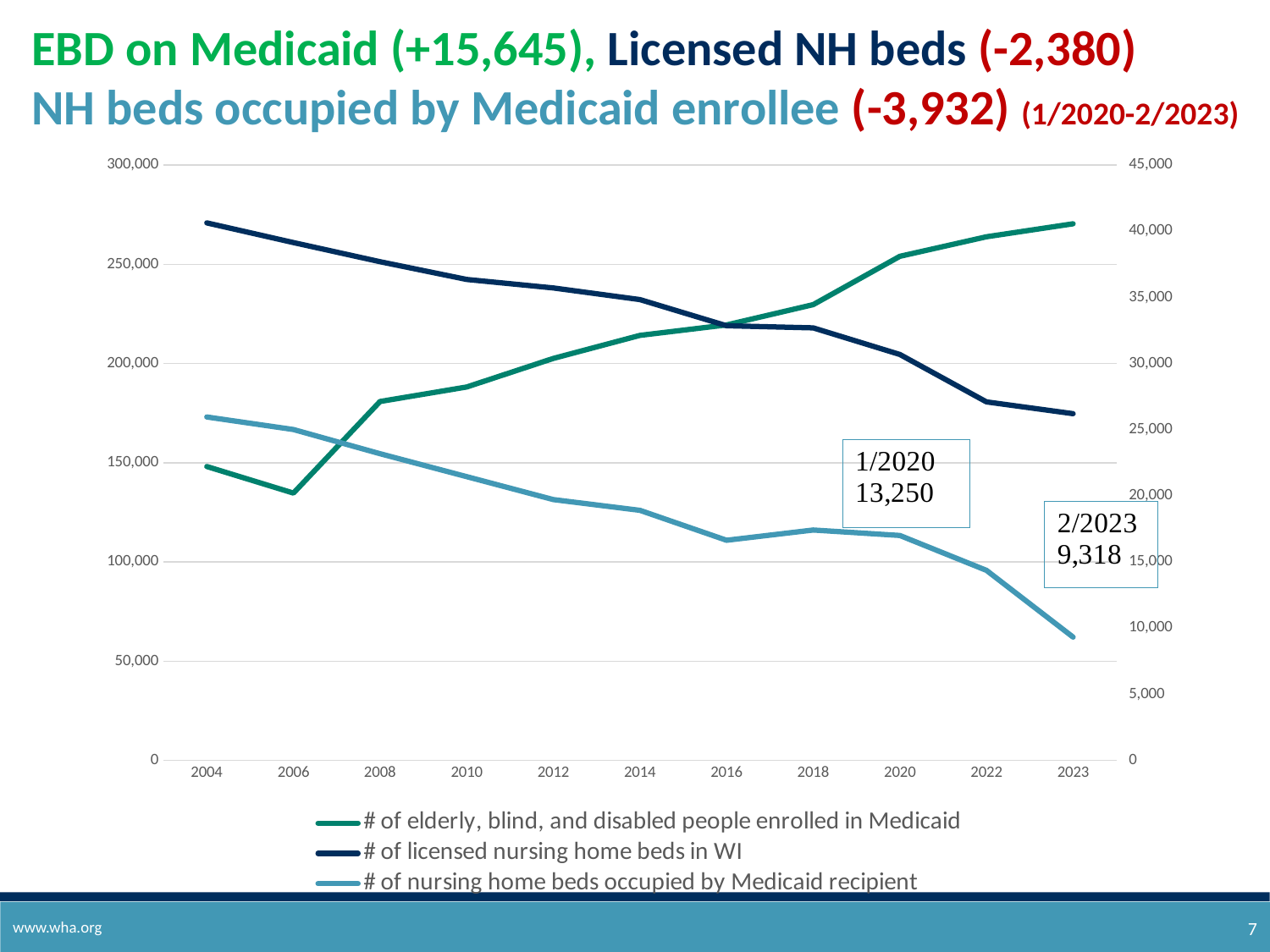
What value is shown in the annotation box labeled 1/2020? 13,250 In which year does the line for # of licensed nursing home beds in WI reach its highest point? 2004 In which year does the line for # of elderly, blind, and disabled people enrolled in Medicaid reach its lowest point? 2006 How many series does the legend list? 3 At 2023, which line is plotted higher on the chart: # of elderly, blind, and disabled people enrolled in Medicaid or # of licensed nursing home beds in WI? # of elderly, blind, and disabled people enrolled in Medicaid In which year does the line for # of nursing home beds occupied by Medicaid recipient reach its lowest point? 2023 What kind of chart is shown on the slide? Line chart How many years are labeled along the x axis? 11 What value is shown in the annotation box labeled 2/2023? 9,318 Does the line for # of elderly, blind, and disabled people enrolled in Medicaid rise or fall overall from 2004 to 2023? Rise Does the line for # of licensed nursing home beds in WI rise or fall from 2004 to 2023? Fall According to the slide title, by how much did NH beds occupied by Medicaid enrollee change from 1/2020 to 2/2023? -3,932